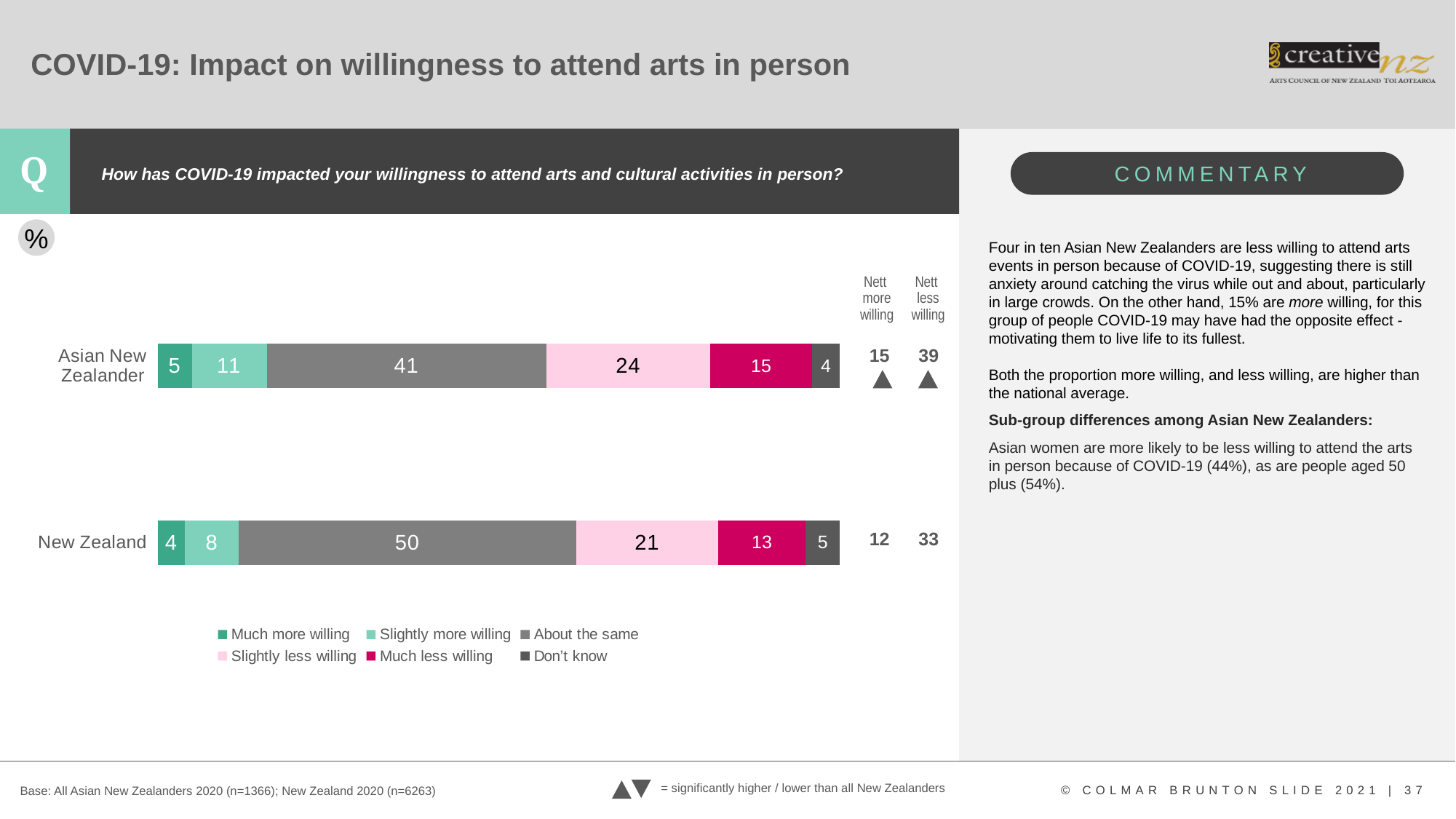
Which response category has the largest share for New Zealand? About the same What is the 'Slightly more willing' value for Asian New Zealanders? 11 Which group has the higher 'Slightly less willing' value, Asian New Zealanders or New Zealand? Asian New Zealander What is the difference between the 'About the same' values for New Zealand and Asian New Zealanders? 9 What percentage of Asian New Zealanders said they are 'About the same' in willingness to attend arts in person? 41 How many series does the legend list? 6 What is the 'Nett less willing' figure for Asian New Zealanders? 39 Which response category has the smallest share for Asian New Zealanders? Don't know What is the 'Don't know' value for New Zealand? 5 What type of chart is shown on the slide? Stacked bar chart How many groups (bars) are shown in the chart? 2 What is the 'Much less willing' value for New Zealand? 13